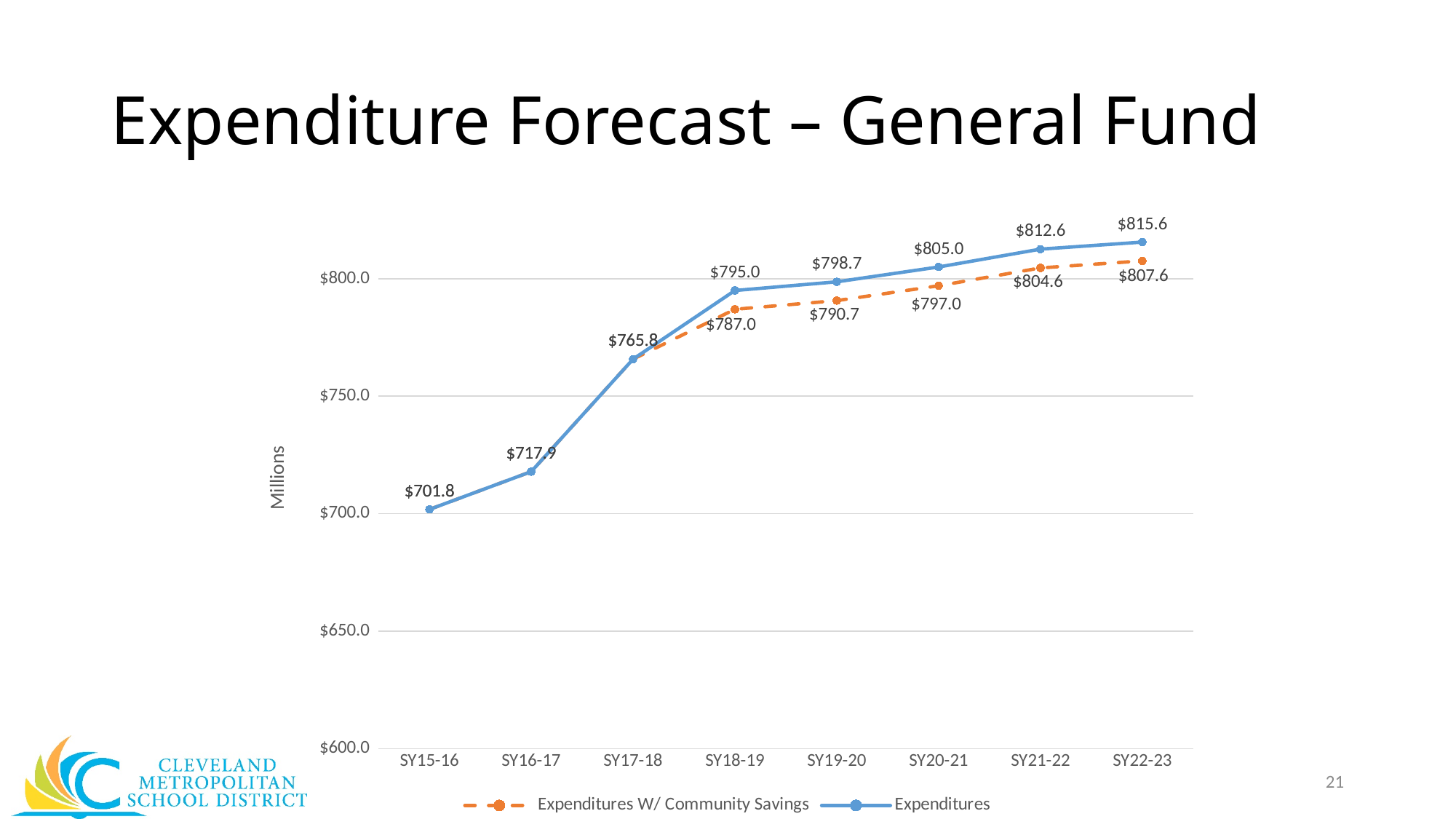
What is the Expenditures W/ Community Savings value for SY20-21? $797.0 Which is larger in SY19-20: Expenditures or Expenditures W/ Community Savings? Expenditures What is the Expenditures value for SY17-18? $765.8 Do the Expenditures values rise or fall from SY15-16 to SY22-23? rise In which school year is the Expenditures series lowest? SY15-16 What is the Expenditures value for SY15-16? $701.8 What is the title of the y axis? Millions What type of chart is shown on the slide? line chart In which school year is the Expenditures series highest? SY22-23 How many school years are shown on the x axis? 8 What is the difference between Expenditures and Expenditures W/ Community Savings in SY22-23? $8.0 How many series does the legend list? 2